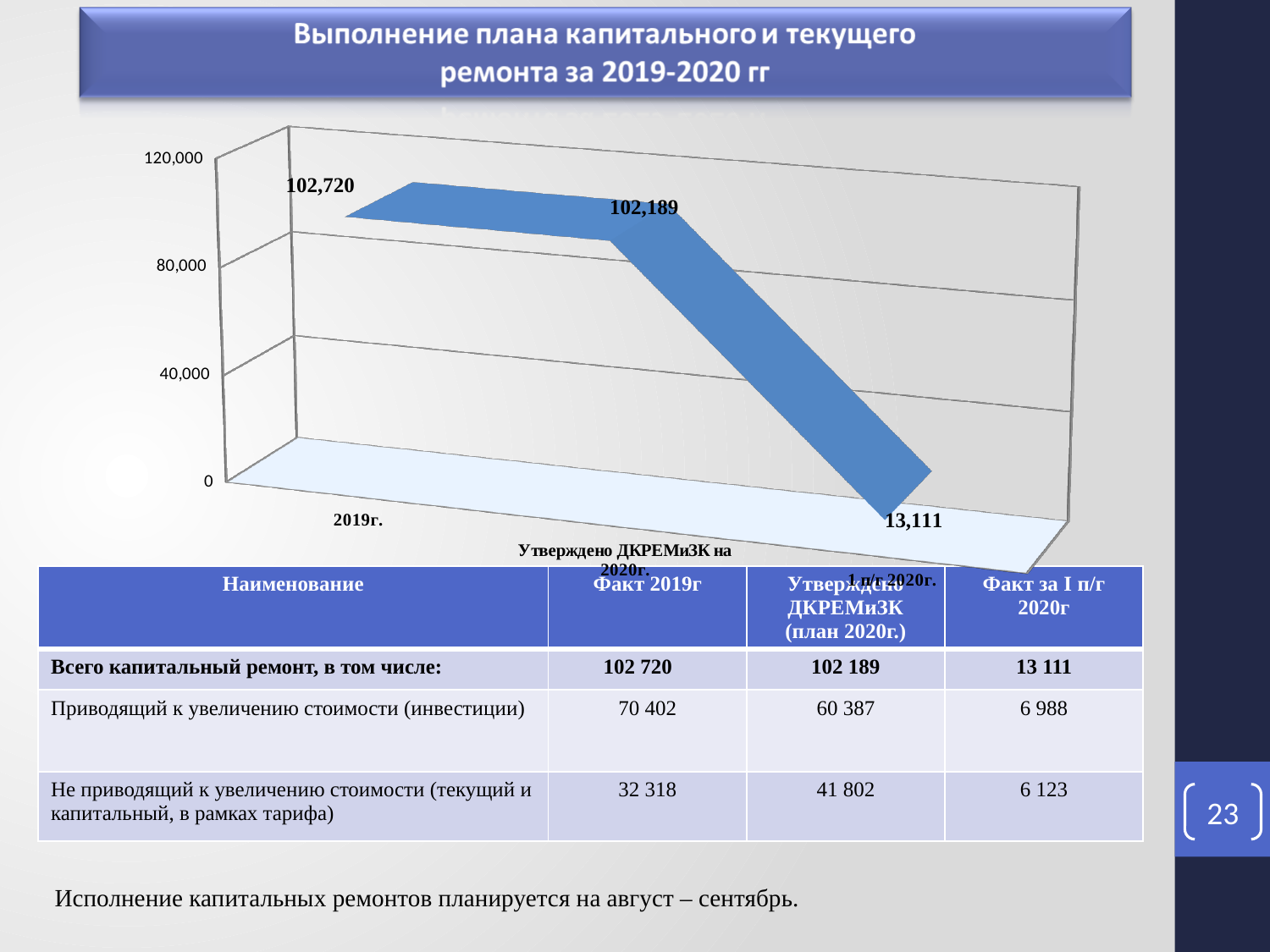
What is the value plotted for 2019г.? 102,720 What is the value plotted for 1 п/г 2020г.? 13,111 Do the values rise or fall from left to right along the x axis? fall How many categories are plotted on the chart? 3 What is the difference between the values for Утверждено ДКРЕМиЗК на 2020г. and 1 п/г 2020г.? 89,078 Which category has the highest value on the chart? 2019г. Is the value for 1 п/г 2020г. greater or less than 40,000? less Which category has the lowest value on the chart? 1 п/г 2020г. What is the title of the slide containing the chart? Выполнение плана капитального и текущего ремонта за 2019-2020 гг What is the value plotted for Утверждено ДКРЕМиЗК на 2020г.? 102,189 Which is larger, the value for 2019г. or the value for 1 п/г 2020г.? 2019г. What is the difference between the values for 2019г. and Утверждено ДКРЕМиЗК на 2020г.? 531